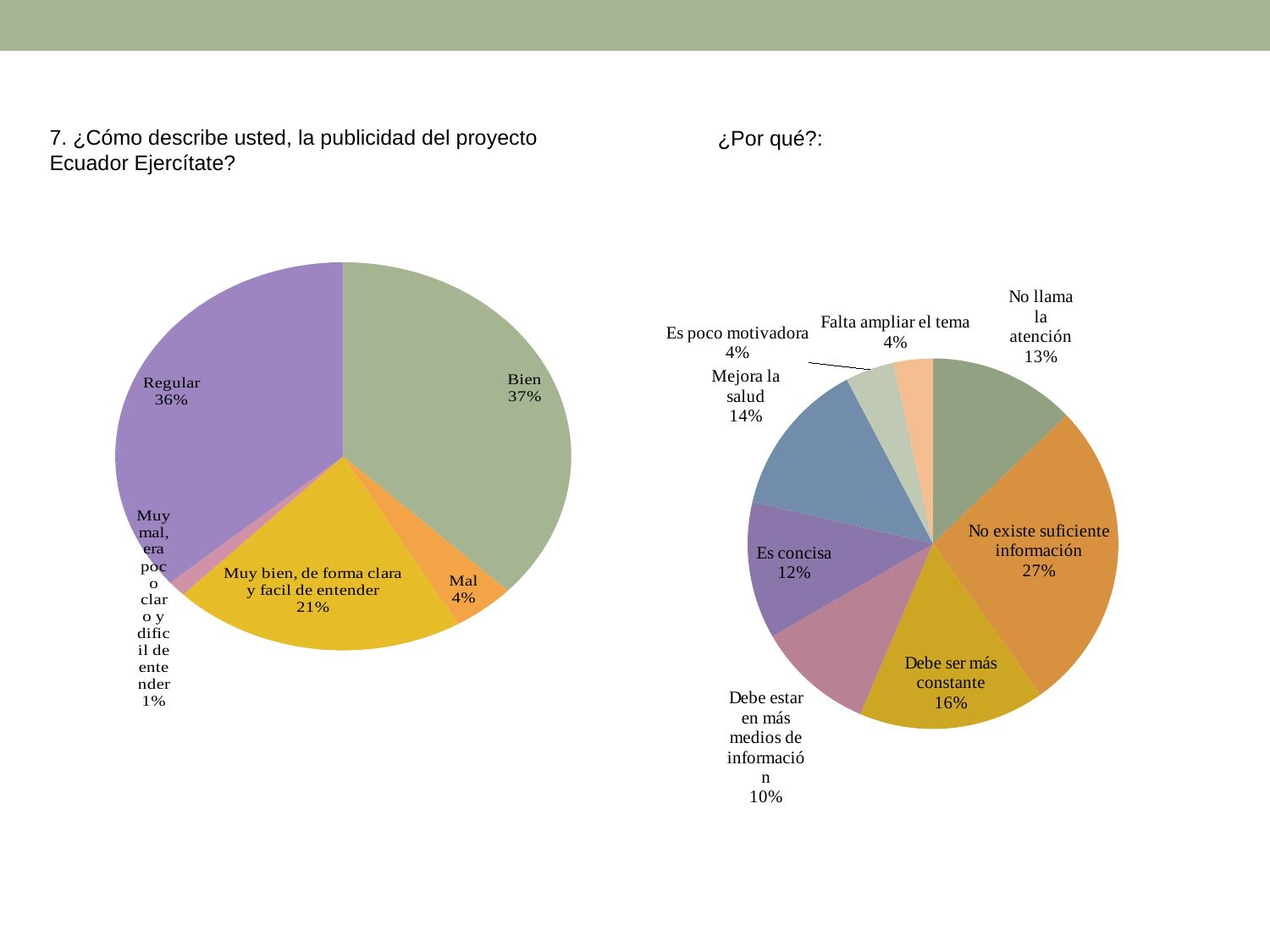
In the right pie chart, what share is labelled for 'No existe suficiente información'? 27% In the right pie chart, what is the difference between the shares for 'No llama la atención' and 'Debe estar en más medios de información'? 3% In the left pie chart, what share is labelled for 'Bien'? 37% In the right pie chart, what share is labelled for 'Mejora la salud'? 14% In the left pie chart, what share is labelled for 'Regular'? 36% In the left pie chart, how many slices are there? 5 In the left pie chart, what is the difference between the shares for 'Bien' and 'Mal'? 33% What type of chart is the left chart on the slide? pie chart In the right pie chart, which category has the largest share? No existe suficiente información In the left pie chart, which category has the smallest share? Muy mal, era poco claro y dificil de entender In the right pie chart, which is larger: 'Debe ser más constante' or 'Es concisa'? Debe ser más constante In the right pie chart, how many slices are there? 8